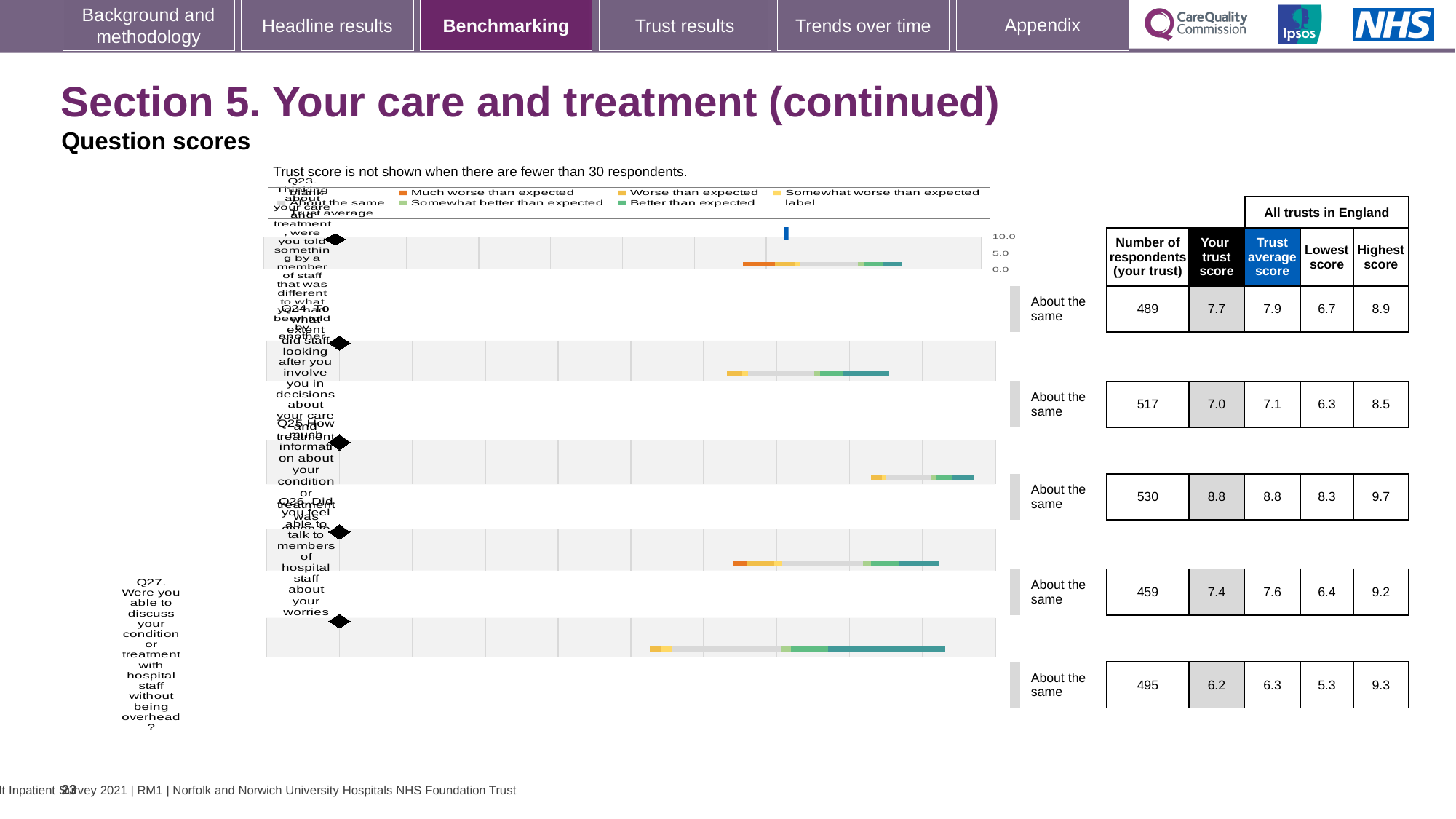
What is the 'Lowest score' for Q26? 6.4 What is the 'Trust average score' for Q25? 8.8 How many questions are shown on the chart? 5 What is the difference between the highest score and the lowest score for Q27? 4.0 What kind of chart is shown on the slide? Bar chart What benchmark category label is shown next to each question's bar? About the same What is the 'Highest score' for Q27? 9.3 Which question has the lowest 'Your trust score'? Q27 For Q23, which is larger: the 'Your trust score' or the 'Trust average score'? Trust average score How many respondents (your trust) are shown for Q23? 489 What is the 'Your trust score' for Q24? 7.0 Which question has the highest 'Your trust score'? Q25